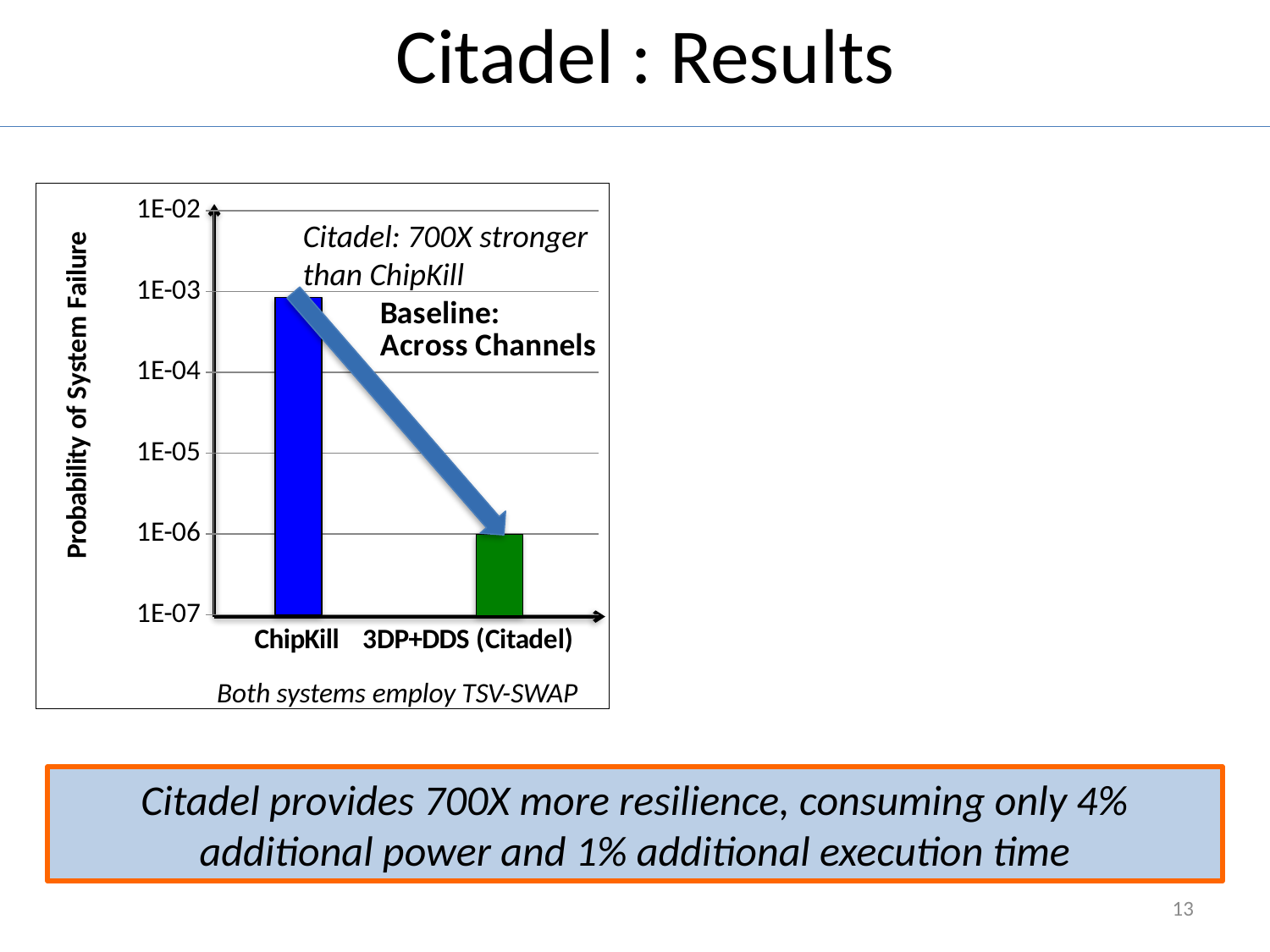
Which category has the lowest probability of system failure? 3DP+DDS (Citadel) What is the label of the y axis of the chart? Probability of System Failure Is the value for 3DP+DDS (Citadel) greater or less than 1E-05? less Which has a larger probability of system failure, ChipKill or 3DP+DDS (Citadel)? ChipKill What colour is the bar for 3DP+DDS (Citadel)? green What is the probability of system failure for 3DP+DDS (Citadel)? 1E-06 Which category has the highest probability of system failure? ChipKill What kind of chart is shown on the slide? bar chart Is the value for ChipKill greater or less than 1E-04? greater Do the values rise or fall moving from ChipKill to 3DP+DDS (Citadel) along the x axis? fall How many categories are plotted on the x axis of the chart? 2